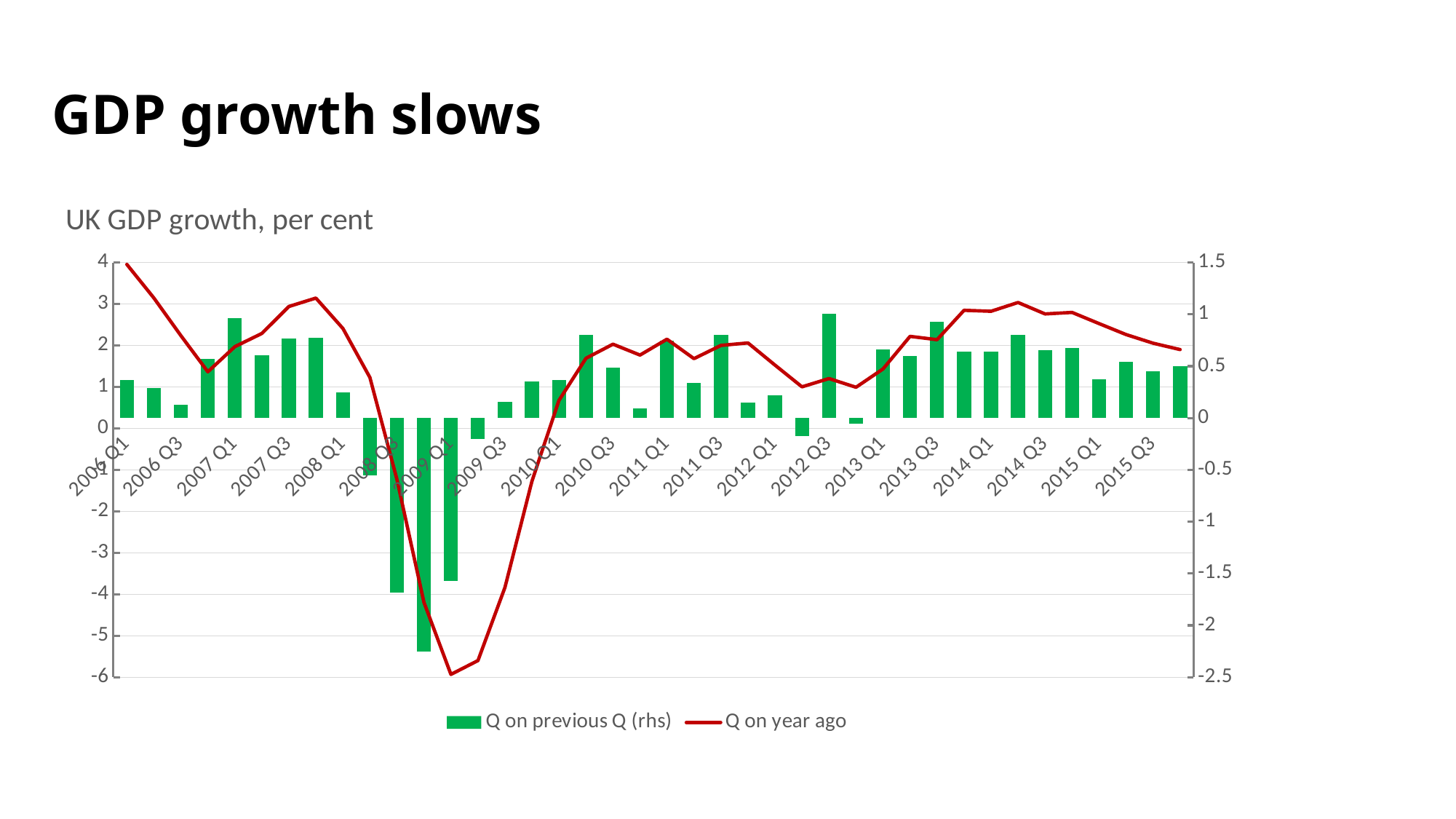
Which is larger for the 'Q on year ago' series: the value at 2006 Q1 or at 2008 Q1? 2006 Q1 Is the 'Q on year ago' value for 2006 Q1 greater or less than 3? greater Which series is plotted as a red line? Q on year ago Is the 'Q on year ago' value for 2009 Q1 greater or less than -5? less Is the 'Q on previous Q (rhs)' value for 2009 Q1 greater or less than -2 on the right-hand axis? greater Which quarter has the lowest 'Q on previous Q (rhs)' bar? 2008 Q4 How many series does the legend list? 2 In which quarter does the 'Q on year ago' line reach its lowest point? 2009 Q1 What kind of chart is shown on the slide? A combination bar and line chart In which quarter does the 'Q on year ago' line reach its highest point? 2006 Q1 Does the 'Q on year ago' line rise or fall between 2014 Q1 and 2015 Q3? fall What is the title of the chart? UK GDP growth, per cent